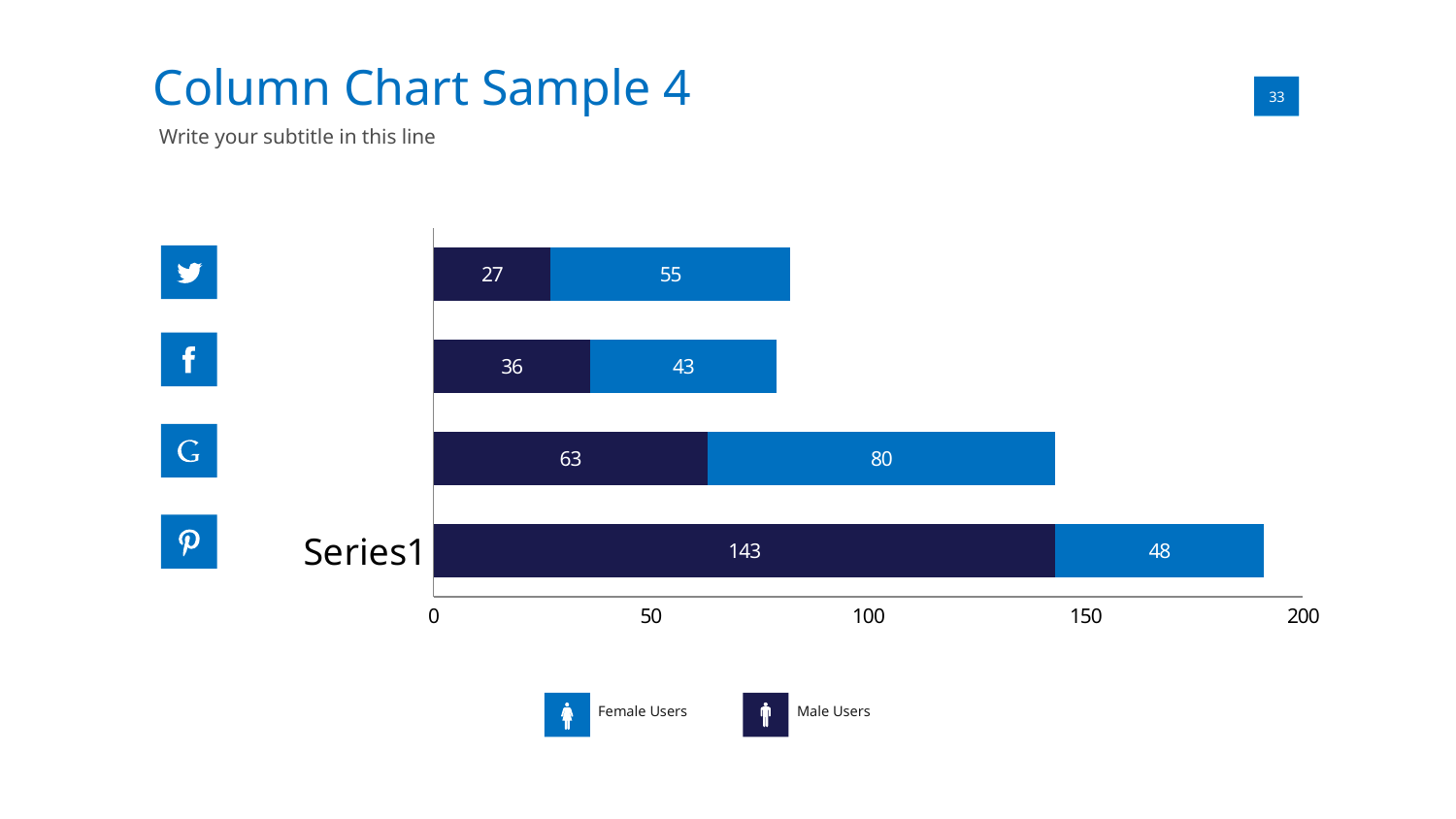
Is the total of the Series1 bar greater or less than 150? greater How many series does the legend list? 2 What are the two legend entries shown below the chart? Female Users and Male Users What is the value of the blue segment of the Series1 bar? 48 What is the value of the dark navy segment of the Series1 bar? 143 What is the difference between the two segments of the Series1 bar (143 and 48)? 95 What is the total of the topmost stacked bar (segments 27 and 55)? 82 Which bar has the largest total length? the Series1 bar (bottom bar) How many bars are plotted in the chart? 4 What kind of chart is shown on the slide? bar chart In the Series1 bar, which segment is larger, the dark navy one or the blue one? the dark navy one What is the total of the Series1 stacked bar? 191